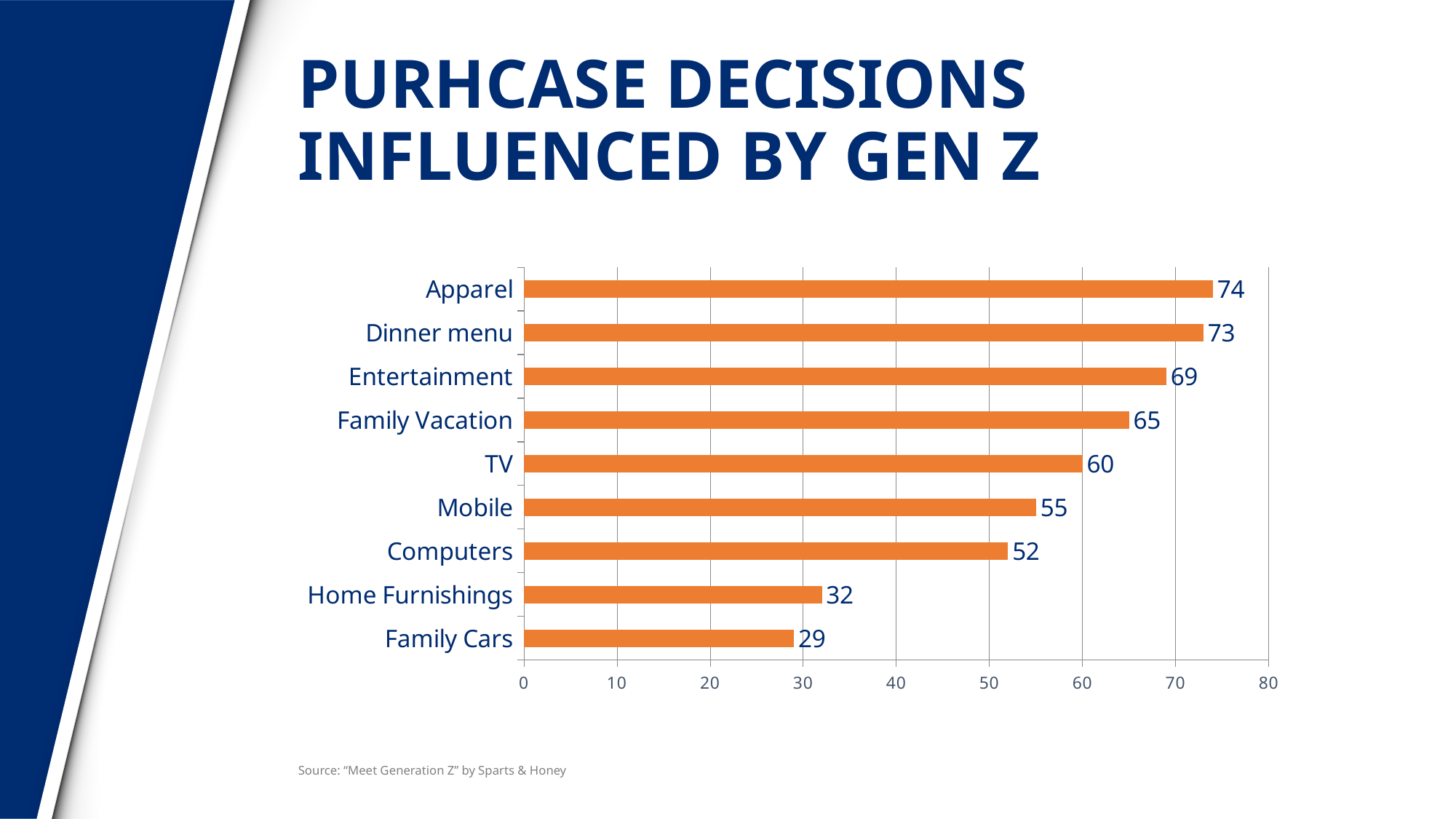
What is the value for Apparel? 74 Which category has the highest value? Apparel What is the value for Family Vacation? 65 What kind of chart is shown on the slide? Bar chart What is the value for Home Furnishings? 32 Which is larger, the value for Dinner menu or the value for Entertainment? Dinner menu Is the value for Computers greater or less than 50? greater How many categories are shown in the chart? 9 What is the difference between the values for TV and Mobile? 5 What is the title of the slide? PURHCASE DECISIONS INFLUENCED BY GEN Z What is the difference between the values for Entertainment and Computers? 17 Which category has the lowest value? Family Cars